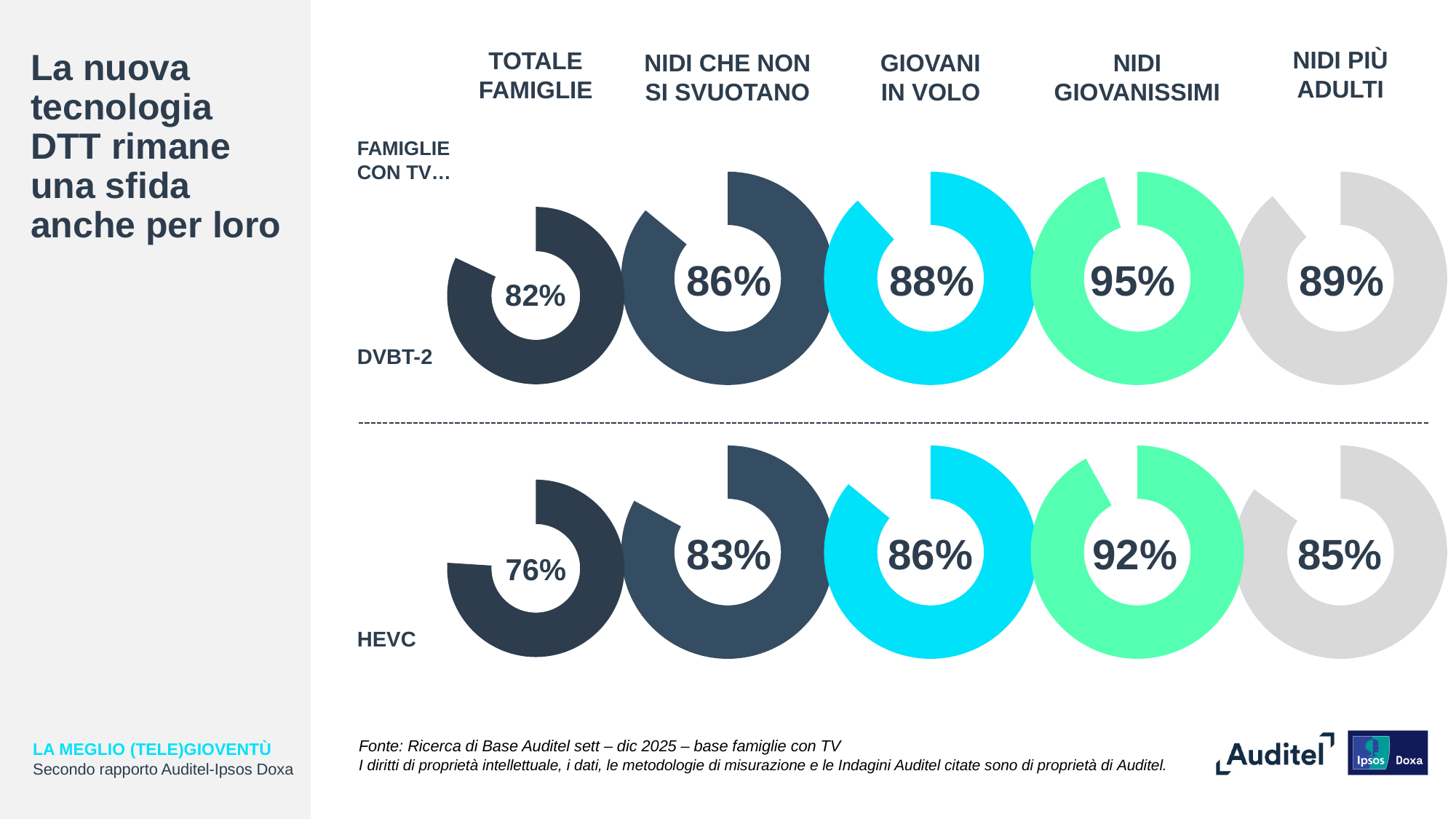
What is the difference between the DVBT-2 values for Nidi Giovanissimi and Nidi Più Adulti? 6 percentage points In the HEVC row, what is the value shown for Nidi Più Adulti? 85% In the HEVC row, which is larger: the value for Nidi che non si svuotano or the value for Giovani in Volo? Giovani in Volo How many donut charts are shown in the DVBT-2 row? 5 In the DVBT-2 row, what is the value shown for Giovani in Volo? 88% What is the difference between the DVBT-2 and HEVC values for Totale Famiglie? 6 percentage points What kind of chart is used to display the percentages on this slide? Donut chart What colour is the donut chart for Giovani in Volo? Cyan (light blue) In the HEVC row, which category has the lowest value? Totale Famiglie In the DVBT-2 row, what is the value shown for Totale Famiglie? 82% In the DVBT-2 row, which category has the highest value? Nidi Giovanissimi In the HEVC row, what is the value shown for Nidi Giovanissimi? 92%